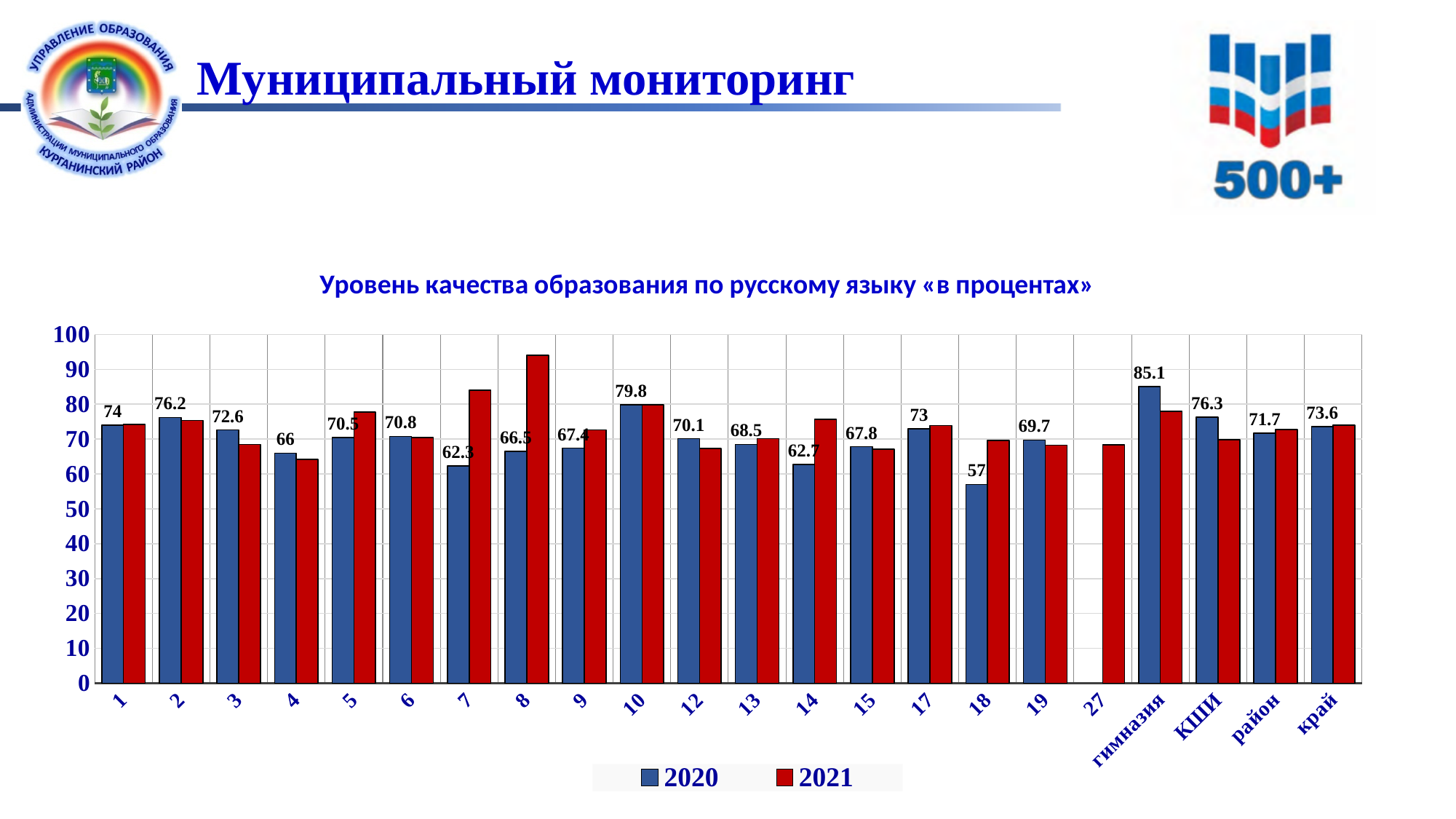
How many categories are shown on the x axis? 22 What is the 2020 value for район? 71.7 What is the difference between the 2020 values for край and район? 1.9 Which category has the lowest 2020 value? 18 What is the 2020 value for гимназия? 85.1 Is the 2021 value for category 27 greater or less than 70? less Which category has the highest 2020 value? гимназия Is the 2021 value for category 8 greater or less than 90? greater What is the difference between the 2020 values for гимназия and category 18? 28.1 What is the 2020 value for category 18? 57 How many series does the legend list? 2 Which has the larger 2020 value, category 2 or category 3? 2